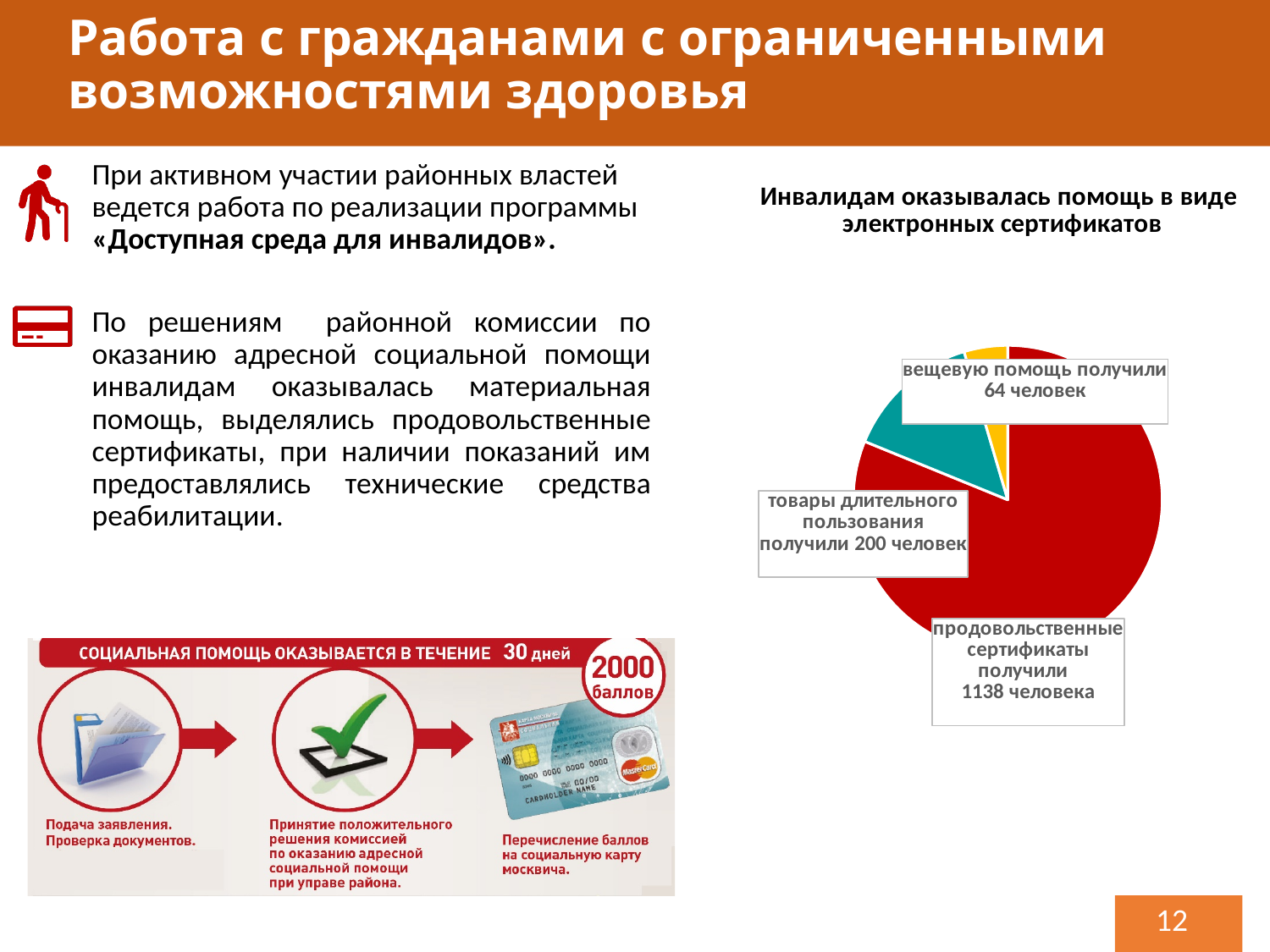
How many people received clothing assistance (вещевую помощь) according to the pie chart? 64 человек What is the title of the pie chart? Инвалидам оказывалась помощь в виде электронных сертификатов How many slices does the pie chart have? 3 How many people received food certificates (продовольственные сертификаты) according to the pie chart? 1138 человека Which category in the pie chart has the smallest number of people? вещевую помощь What is the total number of people across all three slices of the pie chart? 1402 What is the difference between the number of people who received food certificates and those who received durable goods? 938 What is the difference between the number of people who received durable goods and those who received clothing assistance? 136 What kind of chart is shown on the right side of the slide? pie chart Which category in the pie chart has the largest number of people? продовольственные сертификаты Which is larger: the number of people who received durable goods or the number who received clothing assistance? товары длительного пользования How many people received durable goods (товары длительного пользования) according to the pie chart? 200 человек